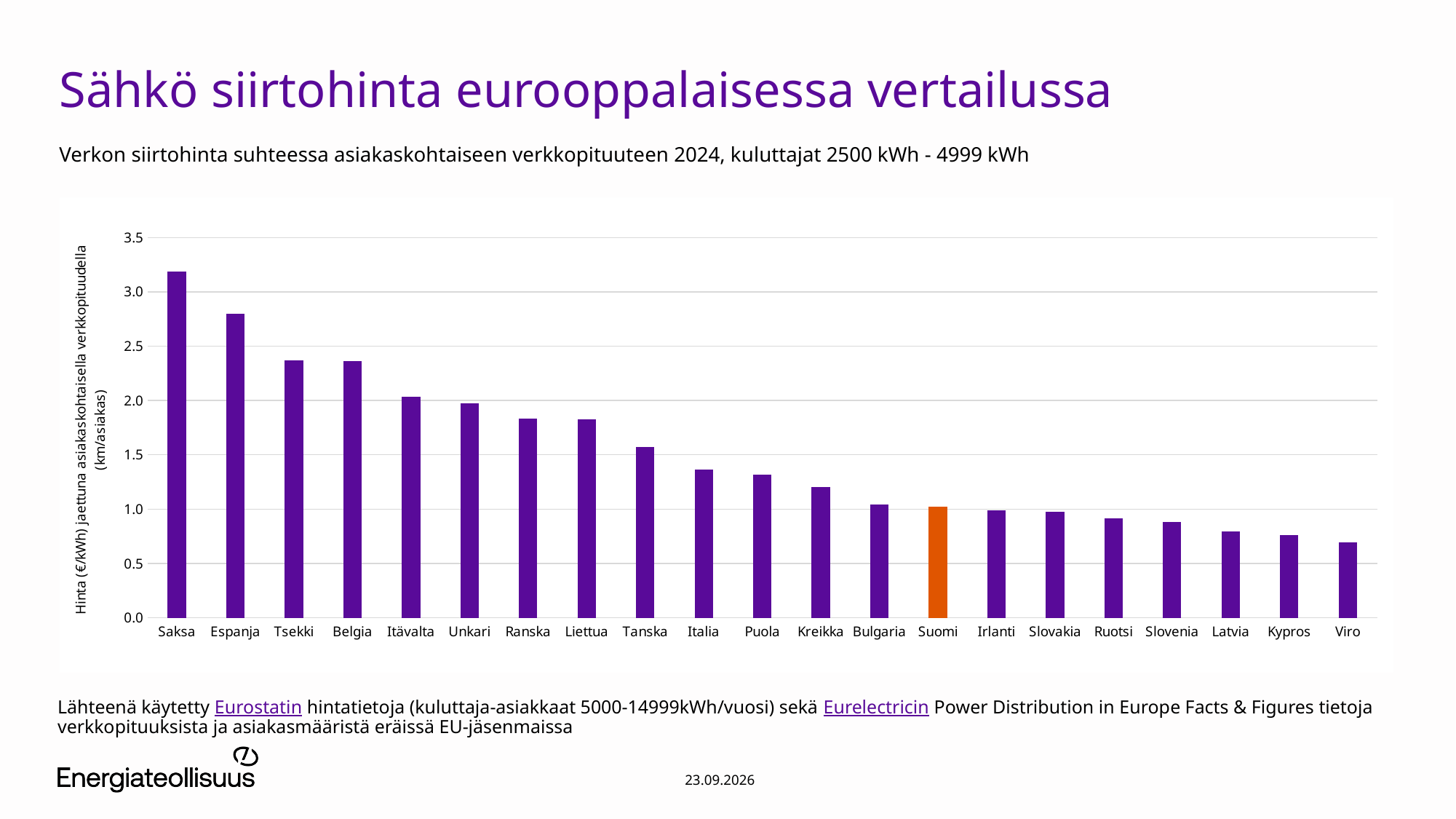
How many countries are shown in the chart? 21 Which country has the lowest value in the chart? Viro Is the value for Viro greater or less than 1.0? less What kind of chart is shown on the slide? bar chart Is the value for Italia greater or less than 1.5? less Is the value for Saksa greater or less than 3.0? greater Which has the larger value, Saksa or Espanja? Saksa Which country's bar is highlighted in orange? Suomi Do the values rise or fall from left to right along the x axis? fall Which country has the highest value in the chart? Saksa